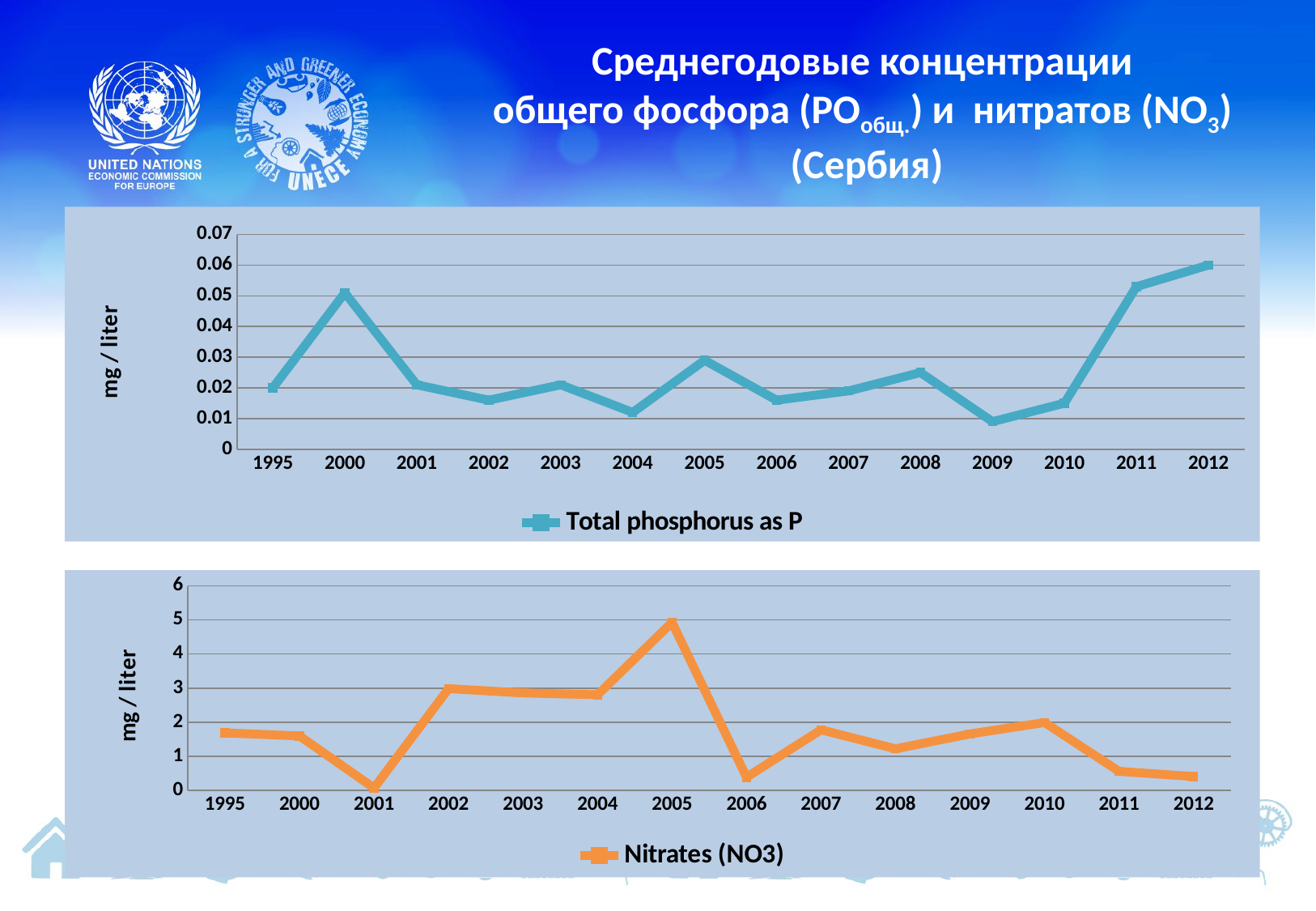
What kind of chart is the bottom chart (Nitrates (NO3))? line chart What kind of chart is the top chart (Total phosphorus as P)? line chart What is the y-axis label of the top chart (Total phosphorus as P)? mg / liter In the bottom chart (Nitrates (NO3)), which year has the larger value, 2002 or 2006? 2002 In the top chart (Total phosphorus as P), is the value for 2000 greater or less than 0.04? greater In the bottom chart (Nitrates (NO3)), is the value for 2005 greater or less than 4? greater In the top chart (Total phosphorus as P), which year has the lowest value? 2009 In the top chart (Total phosphorus as P), how many years are plotted on the x axis? 14 In the bottom chart (Nitrates (NO3)), how many series does the legend list? 1 In the bottom chart (Nitrates (NO3)), which year has the lowest value? 2001 In the top chart (Total phosphorus as P), which year has the highest value? 2012 In the bottom chart (Nitrates (NO3)), which year has the highest value? 2005